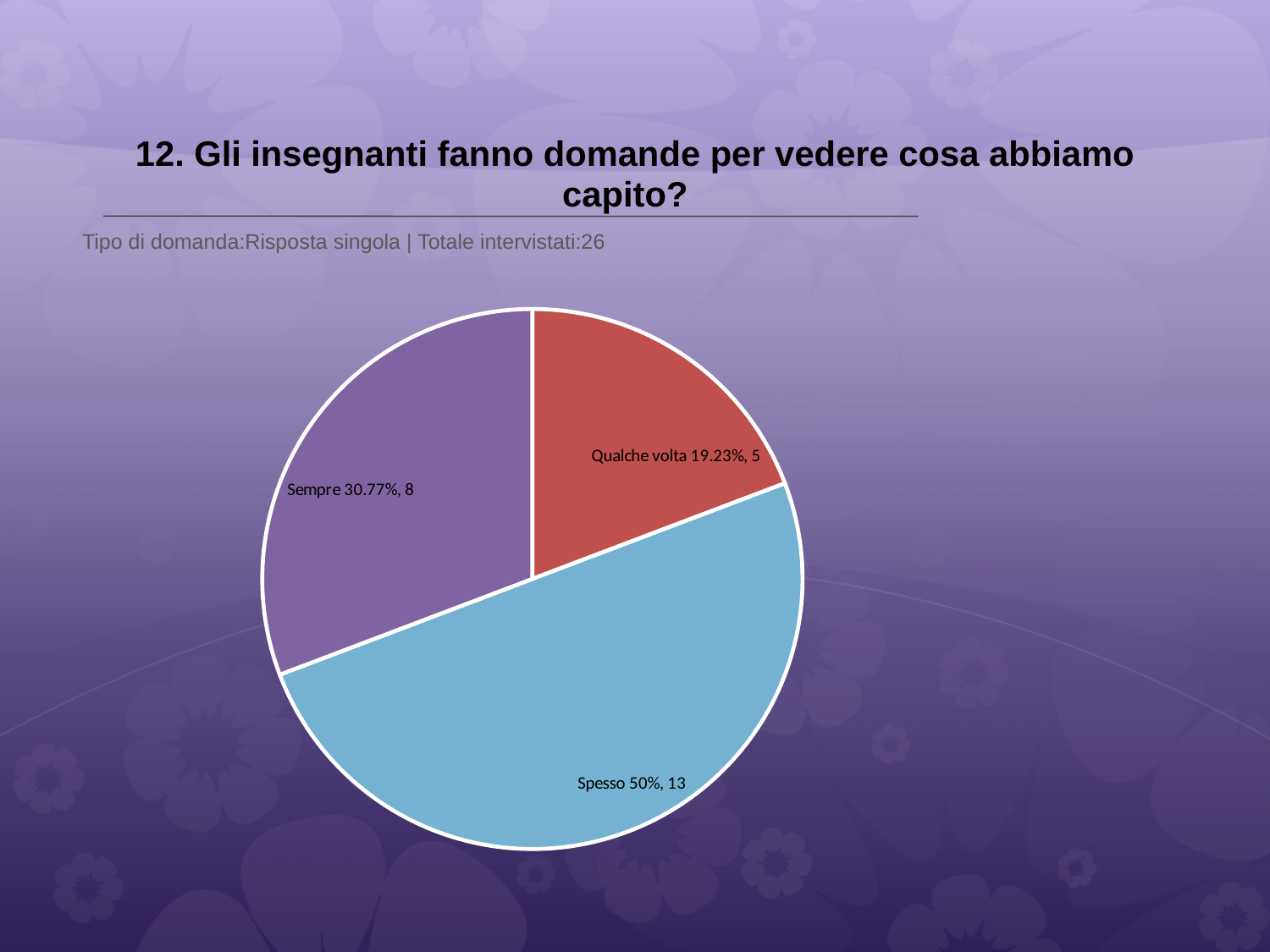
What kind of chart is shown on the slide? pie chart Which response has the smallest slice of the pie? Qualche volta How many respondents answered "Spesso"? 13 What percentage share does the "Sempre" slice have? 30.77% How many respondents answered "Sempre"? 8 Which response has the largest slice of the pie? Spesso How many slices does the pie chart have? 3 Which slice is larger, "Sempre" or "Qualche volta"? Sempre What is the difference in respondent count between "Spesso" and "Sempre"? 5 What percentage share does the "Spesso" slice have? 50% How many respondents answered "Qualche volta"? 5 What percentage share does the "Qualche volta" slice have? 19.23%